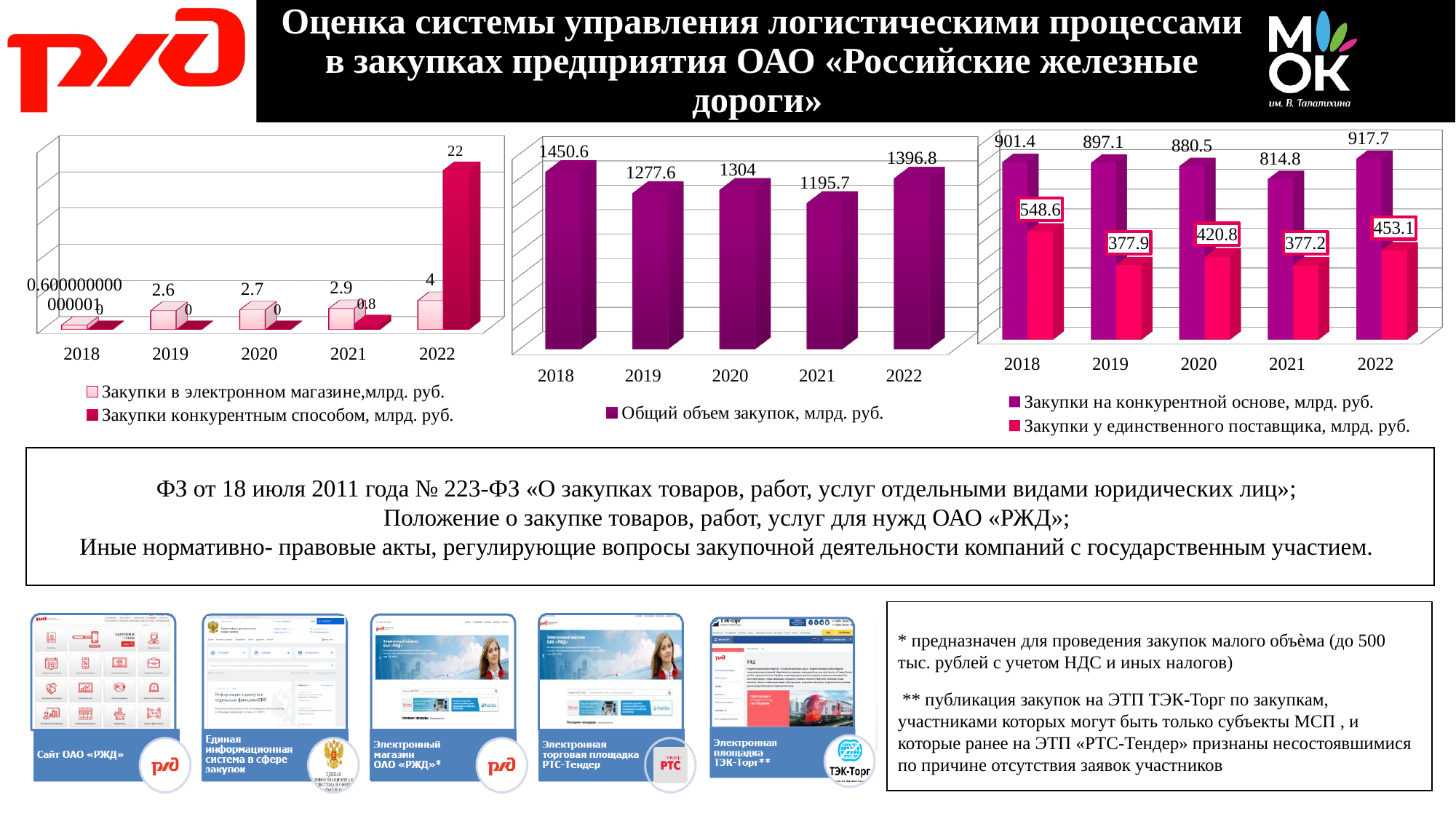
In the middle chart, which year has the lowest total procurement volume? 2021 In the middle chart, what is the value of Общий объем закупок for 2018? 1450.6 In the right chart, what is the value of Закупки у единственного поставщика for 2020? 420.8 In the right chart, which is larger: Закупки у единственного поставщика in 2018 or in 2022? 2018 In the left chart, what is the value of Закупки в электронном магазине for 2021? 2.9 In the left chart, what is the value of Закупки конкурентным способом for 2022? 22 What type of chart is the middle chart? Bar chart In the right chart, which year has the highest value for Закупки на конкурентной основе? 2022 In the right chart, what is the difference between Закупки на конкурентной основе and Закупки у единственного поставщика in 2021? 437.6 In the middle chart, what is the difference between the 2018 and 2022 values? 53.8 How many years are shown on the x axis of the middle chart? 5 How many series does the legend of the right chart list? 2